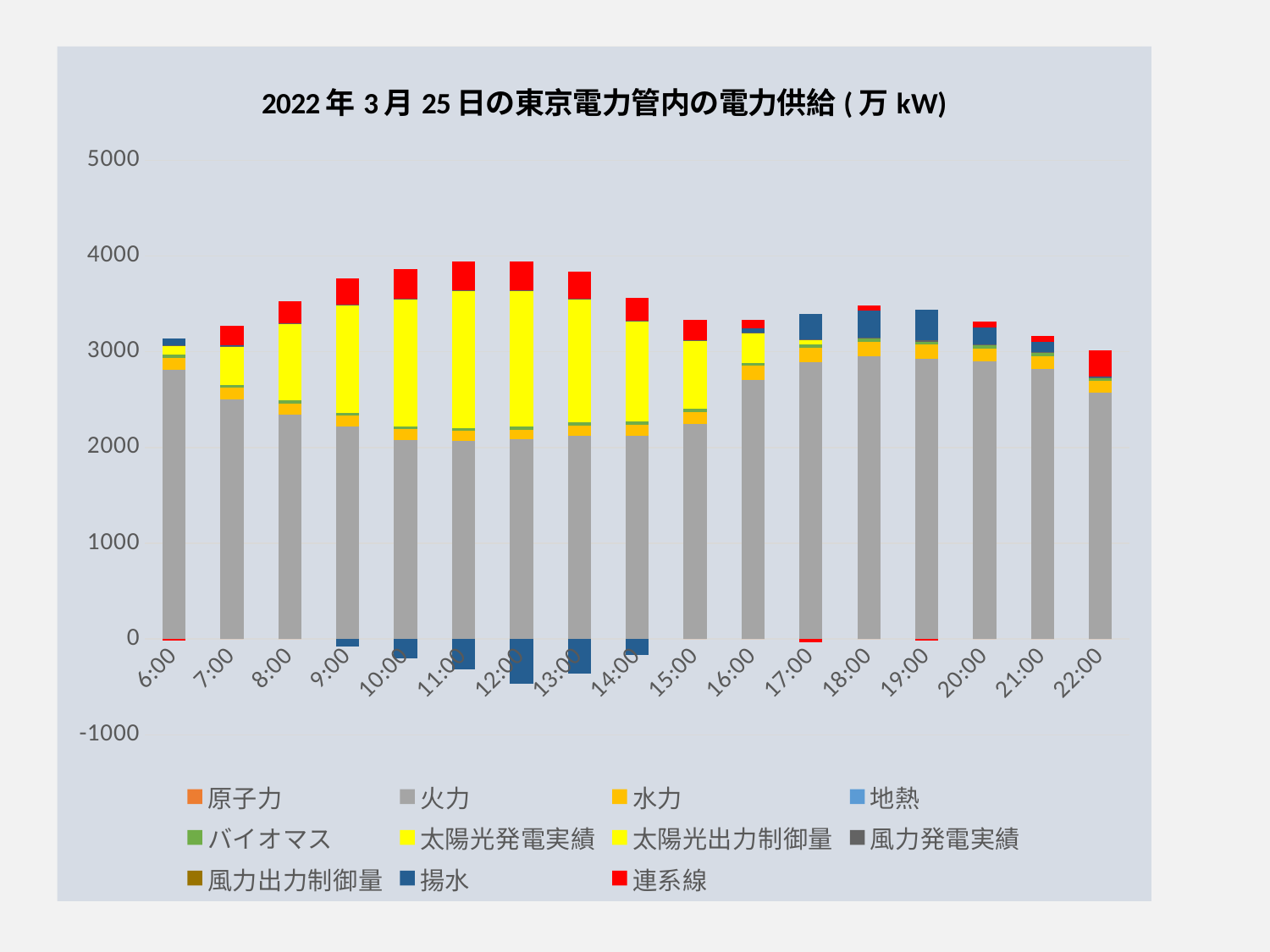
Is the value for 火力 at 12:00 greater or less than 3000? less Is the value for 火力 at 6:00 greater or less than 2000? greater How many series does the legend list? 11 What kind of chart is shown on the slide? Stacked bar chart Which is larger, the 火力 value at 6:00 or at 12:00? 6:00 What is the title of the chart? 2022年3月25日の東京電力管内の電力供給(万kW) Does the 火力 value rise or fall from 6:00 to 11:00? fall Is the value for 揚水 at 12:00 greater or less than 0? less How many time points are shown along the x axis? 17 What colour represents 連系線 in the legend? Red Which is larger, the 太陽光発電実績 value at 12:00 or at 16:00? 12:00